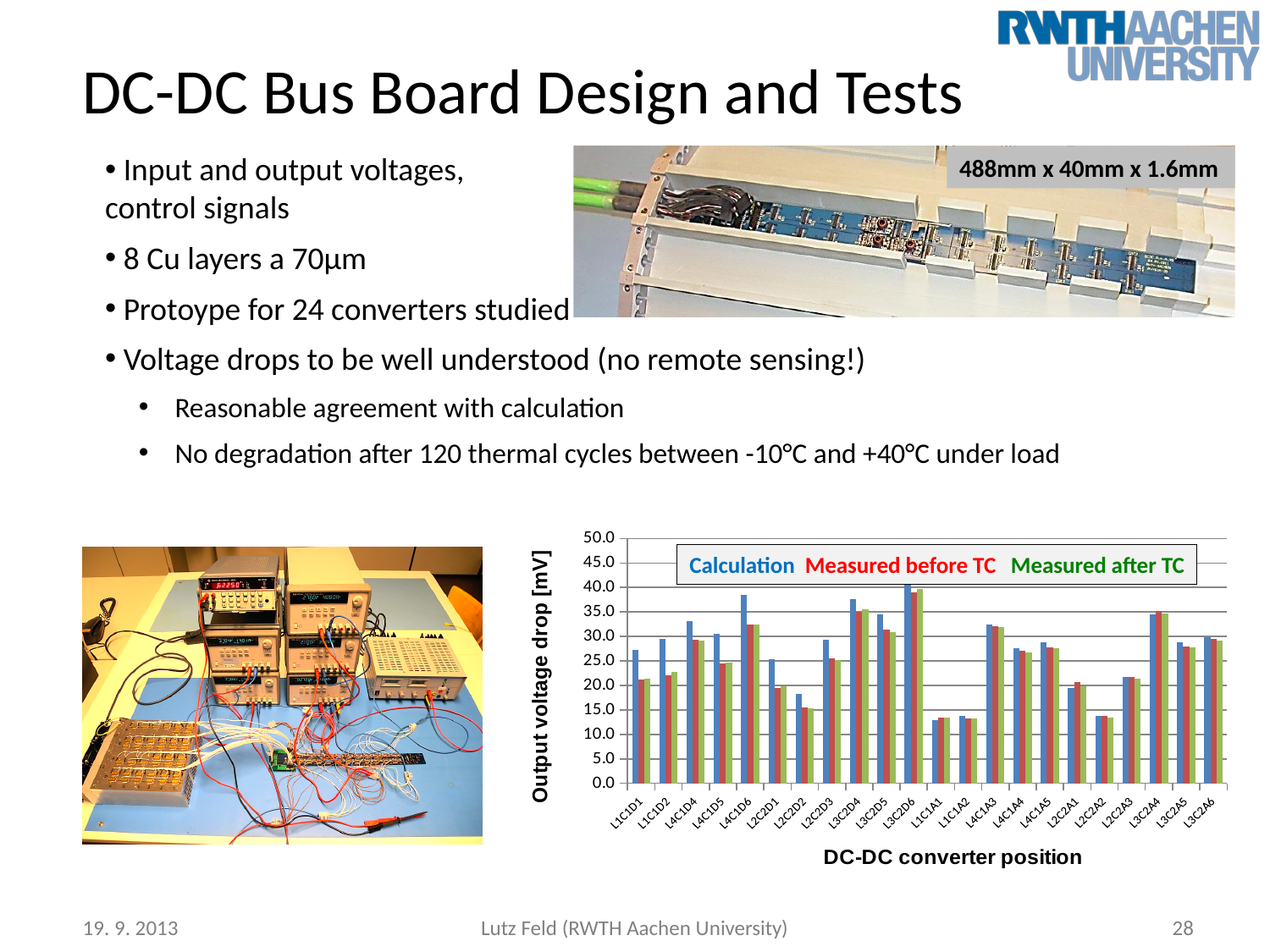
What is the x-axis title of the bar chart? DC-DC converter position Is the Calculation value for L4C1D6 greater or less than 35? greater Is the Calculation value for L1C1D1 greater or less than 25? greater What is the y-axis title of the bar chart? Output voltage drop [mV] Which has the larger Measured before TC value, L3C2D6 or L1C1A2? L3C2D6 Is the Measured after TC value for L2C2D2 greater or less than 20? less Which has the larger Calculation value, L4C1D6 or L2C2D1? L4C1D6 How many series does the legend of the bar chart list? 3 Which converter position has the highest Calculation value in the bar chart? L3C2D6 What kind of chart is shown at the bottom right of the slide? bar chart